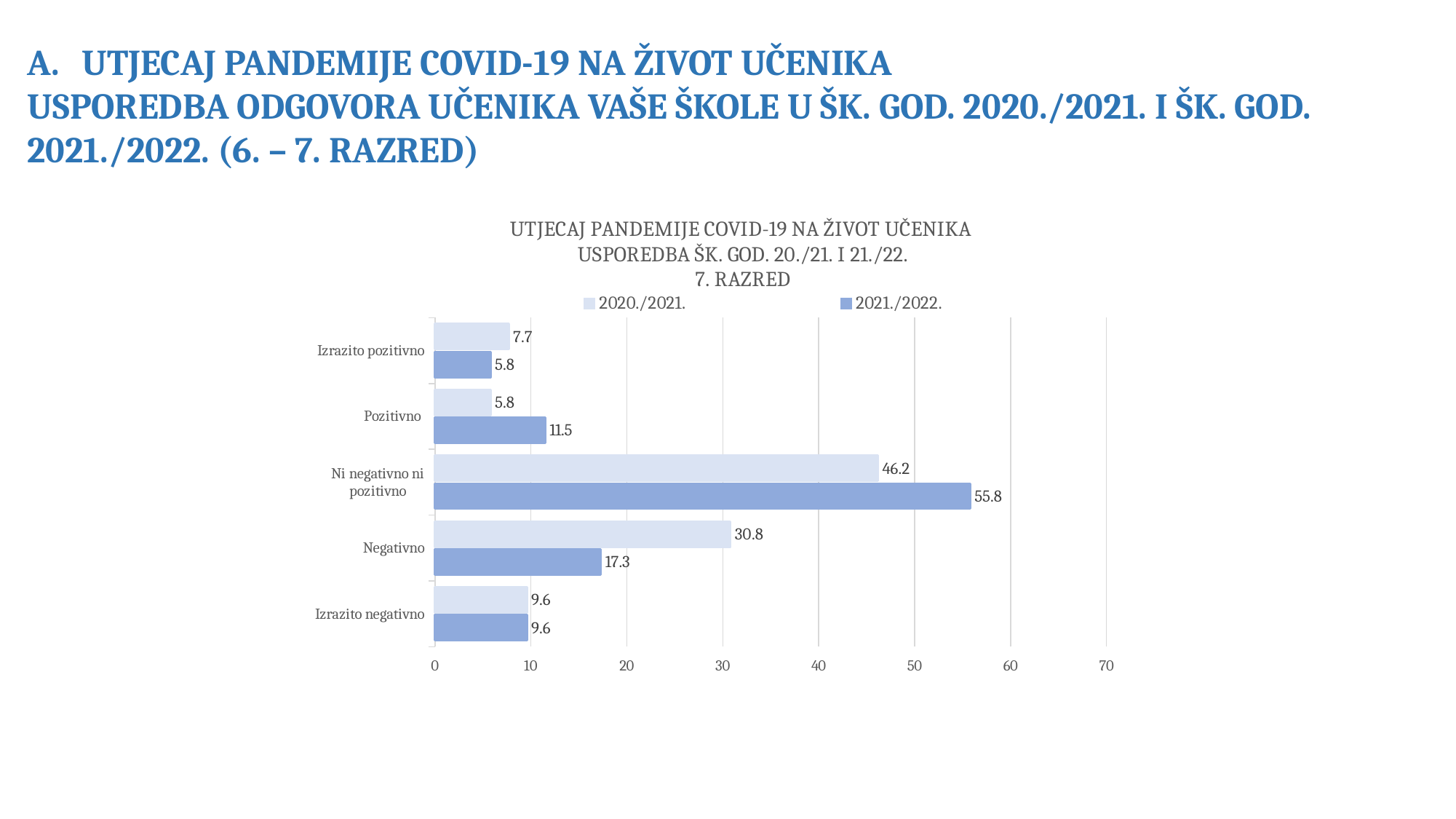
What is the value for 'Ni negativno ni pozitivno' in the 2021./2022. series? 55.8 Which category has the highest value in the 2020./2021. series? Ni negativno ni pozitivno How many series does the legend list? 2 What kind of chart is shown on the slide? Bar chart Which series has the larger value for 'Pozitivno', 2020./2021. or 2021./2022.? 2021./2022. What is the value for 'Negativno' in the 2020./2021. series? 30.8 What is the difference between the 2021./2022. and 2020./2021. values for 'Ni negativno ni pozitivno'? 9.6 What is the difference between the 2020./2021. and 2021./2022. values for 'Negativno'? 13.5 What are the two series named in the legend? 2020./2021. and 2021./2022. How many categories are shown on the chart? 5 Which category has the lowest value in the 2021./2022. series? Izrazito pozitivno What is the value for 'Pozitivno' in the 2021./2022. series? 11.5